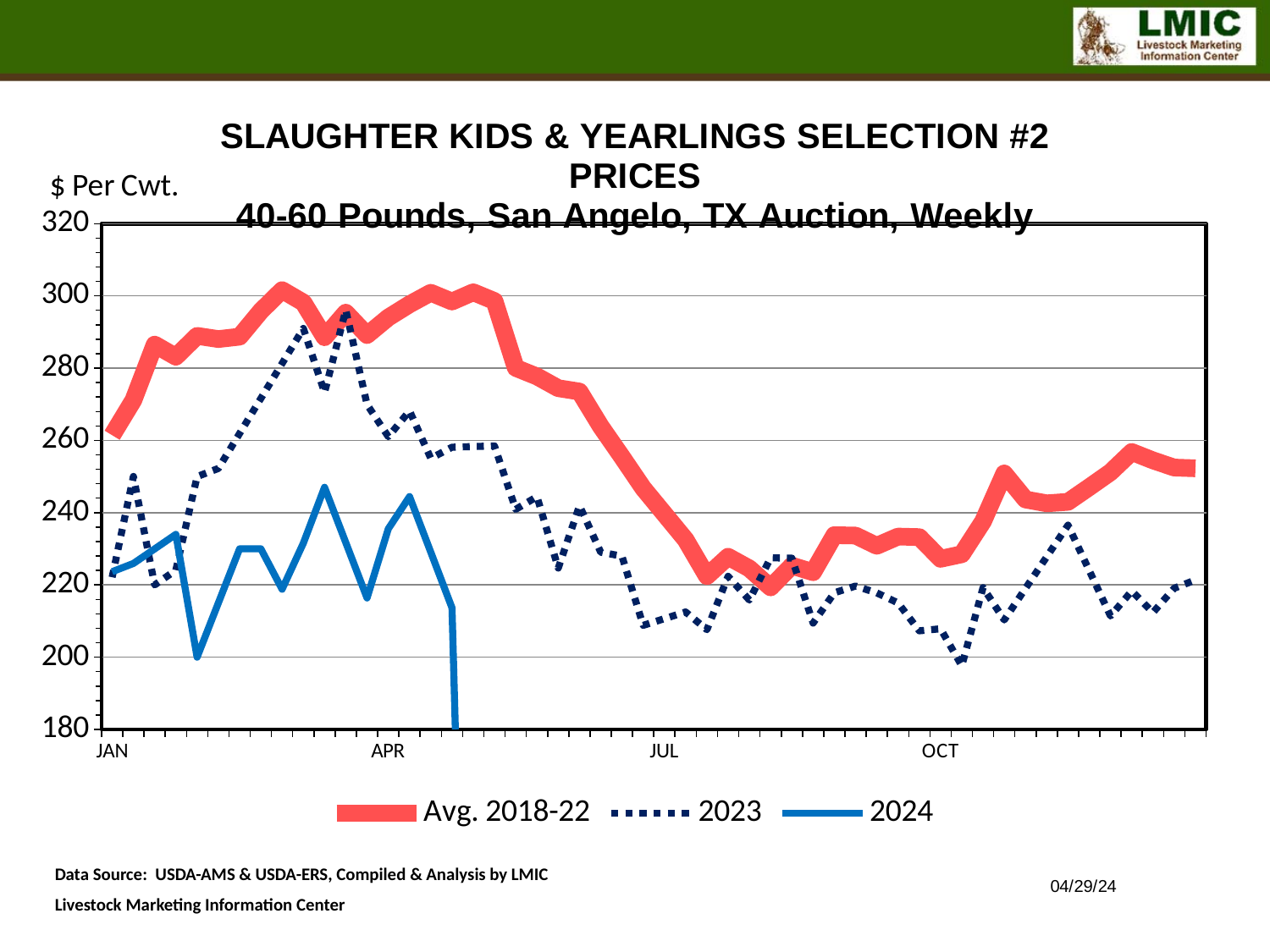
At APR, which series has the larger value: Avg. 2018-22 or 2024? Avg. 2018-22 Does the 2023 series rise or fall between JAN and APR? rise Is the value of the Avg. 2018-22 series at JUL greater or less than 260? less Which series is drawn as a dotted line in the chart? 2023 How many series does the legend list? 3 Is the value of the 2023 series at OCT greater or less than 220? less Is the value of the Avg. 2018-22 series at APR greater or less than 280? greater What kind of chart is shown on the slide? line chart What is the label on the y axis of the chart? $ Per Cwt. At JUL, which series has the larger value: Avg. 2018-22 or 2023? Avg. 2018-22 Does the Avg. 2018-22 series rise or fall between APR and JUL? fall